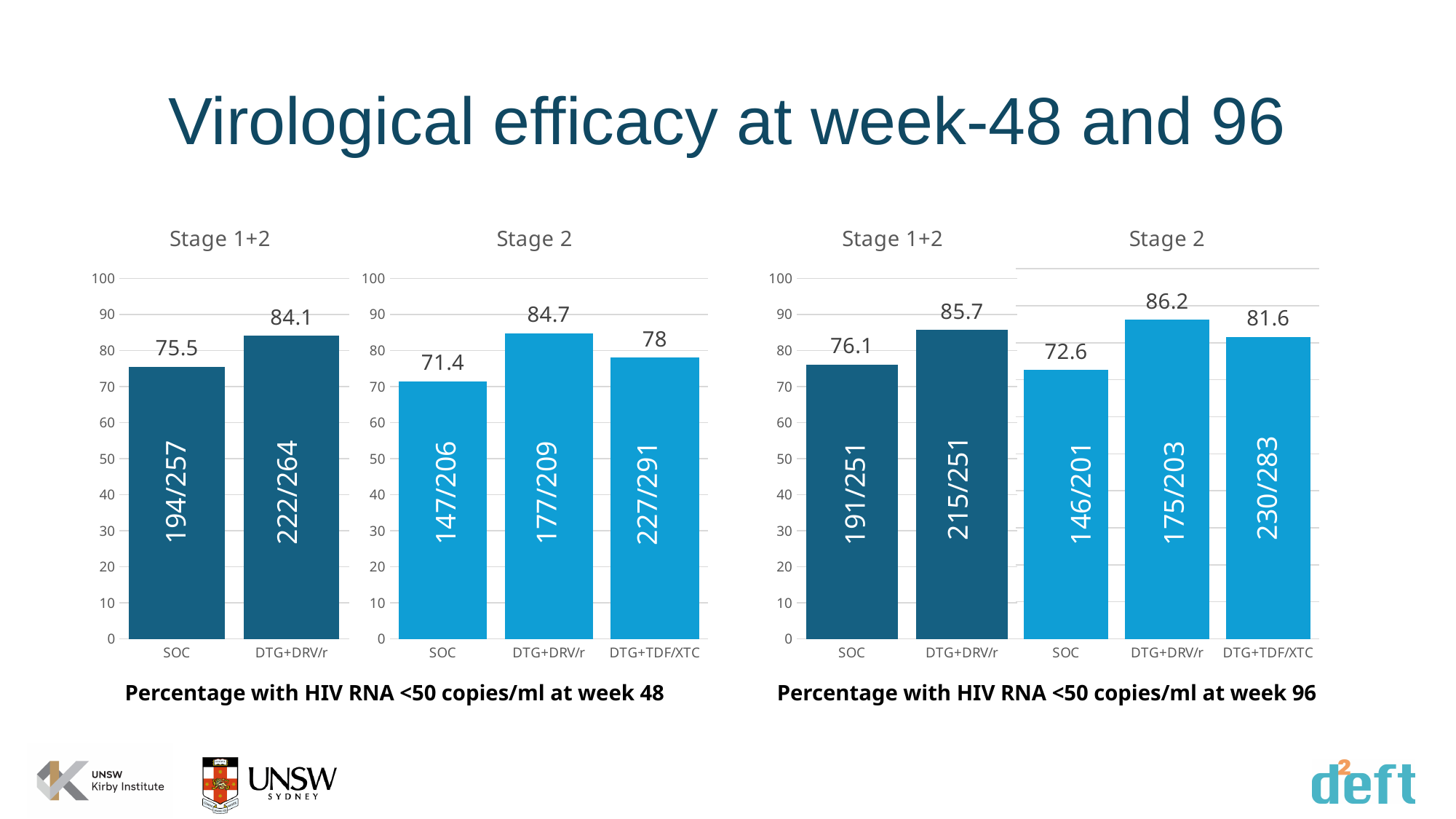
In the week 96 chart, Stage 2 panel, what is the difference between DTG+DRV/r and DTG+TDF/XTC? 4.6 In the week 48 chart, Stage 2 panel, which category has the highest value? DTG+DRV/r In the week 96 chart, Stage 1+2 panel, what fraction is printed inside the DTG+DRV/r bar? 215/251 What is the caption below the right-hand chart? Percentage with HIV RNA <50 copies/ml at week 96 In the week 96 chart, Stage 2 panel, which category has the lowest value? SOC In the week 48 chart, Stage 1+2 panel, what is the value for SOC? 75.5 In the week 48 chart, Stage 1+2 panel, what is the difference between DTG+DRV/r and SOC? 8.6 In the week 96 chart, Stage 1+2 panel, which is larger: SOC or DTG+DRV/r? DTG+DRV/r In the week 96 chart, Stage 2 panel, what is the value for DTG+DRV/r? 86.2 How many bars are in the Stage 2 panel of the week 48 chart? 3 In the week 48 chart, Stage 2 panel, what is the value for DTG+TDF/XTC? 78 What kind of chart is used on this slide? Bar chart